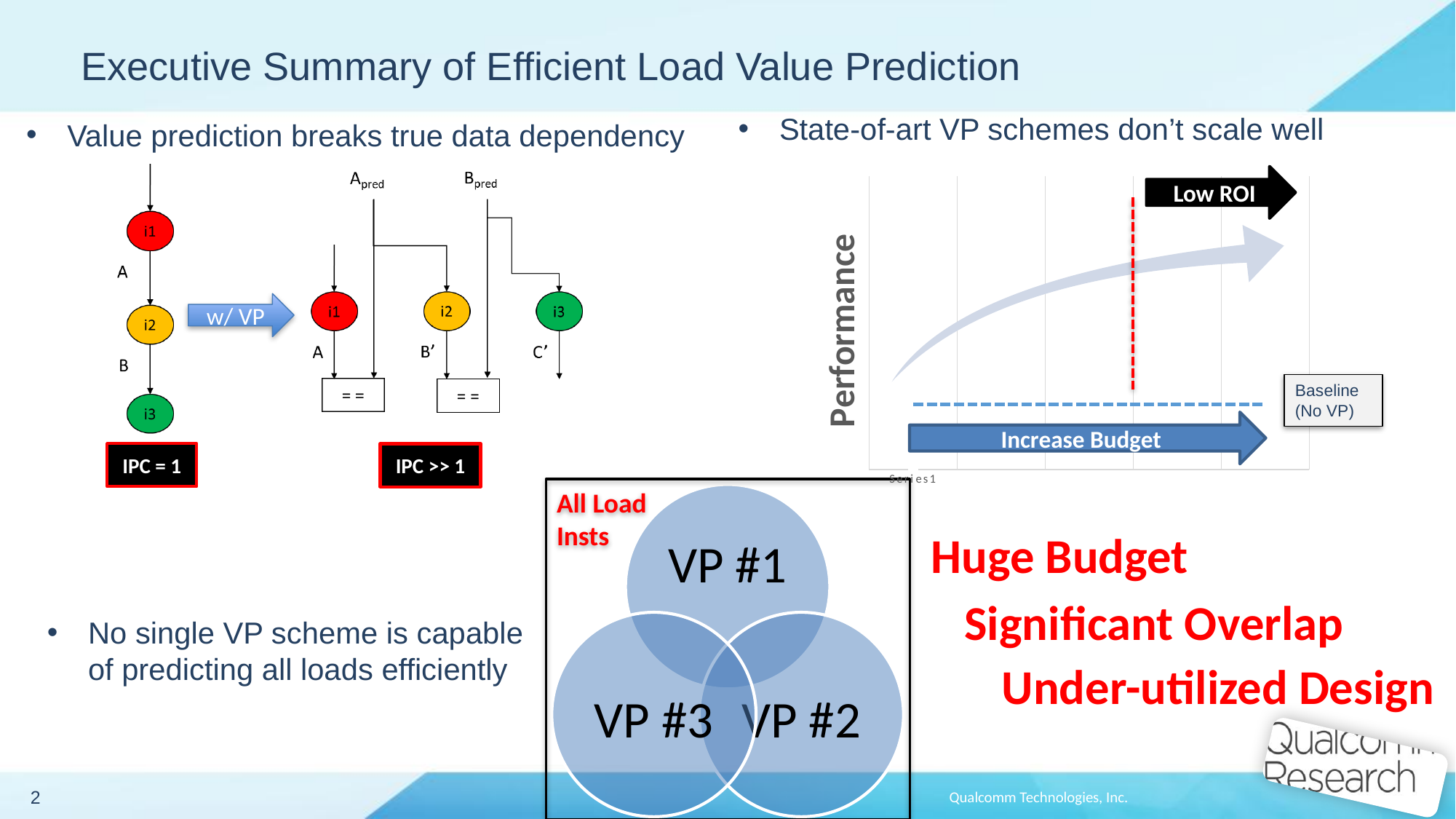
In the Performance chart on the right, does performance rise or fall as the budget increases along the x axis? rise In the Performance chart, what label appears on the black arrow at the top right, beyond the red dashed vertical line? Low ROI In the Venn diagram at the bottom of the slide, how many VP schemes (circles) are shown? 3 What does the dashed horizontal line in the Performance chart represent, according to its label? Baseline (No VP) What is the label on the vertical axis of the chart on the right side of the slide? Performance In the Performance chart, what label is shown on the large horizontal arrow along the x axis? Increase Budget